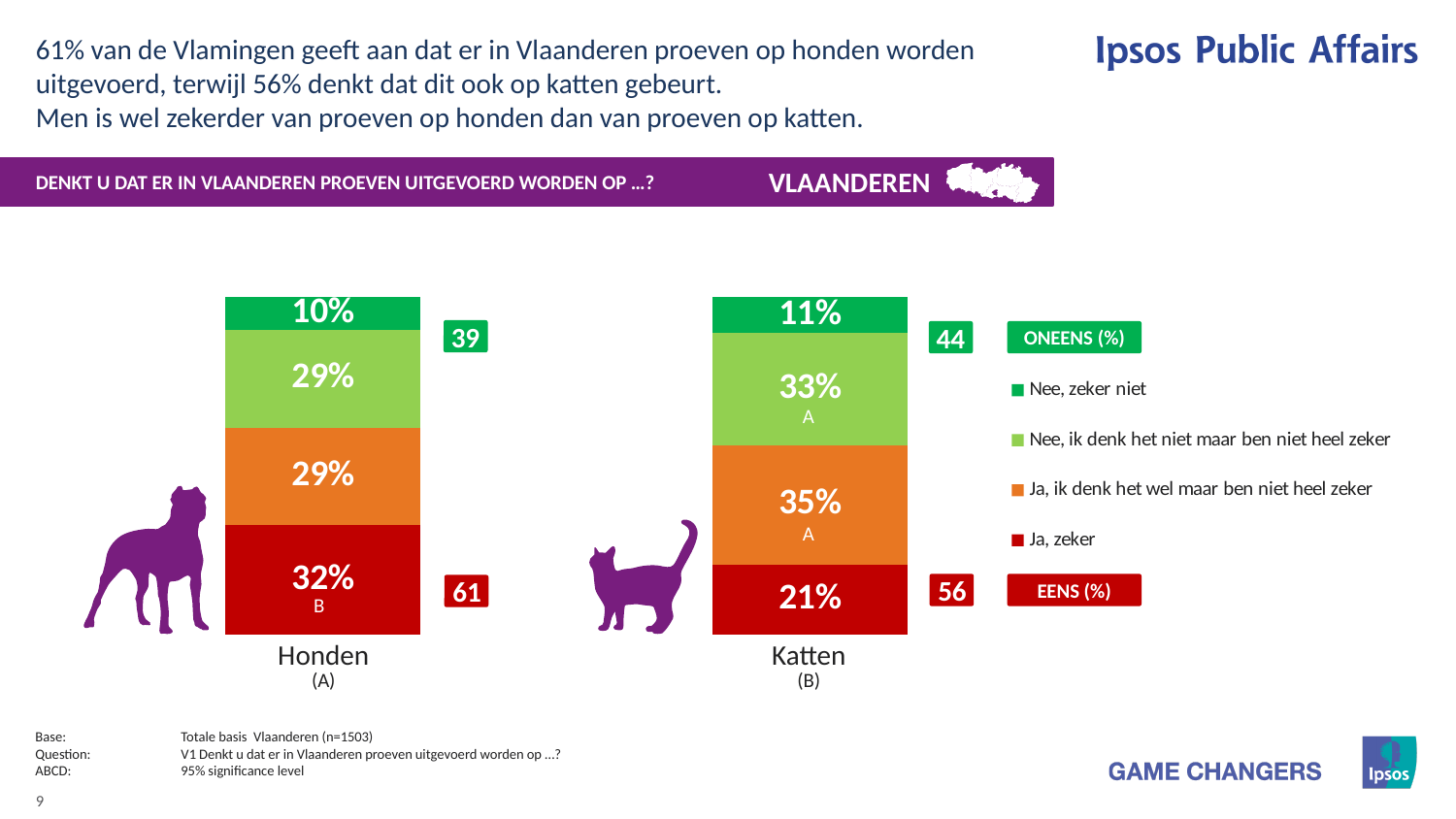
What is the combined share of the two "Ja" segments for Katten? 56% What is the value of the "Nee, zeker niet" segment for Katten? 11% What kind of chart is shown on the slide? Stacked bar chart How many series does the legend list? 4 What percentage of respondents answered "Ja, zeker" for Honden? 32% How many categories are shown on the x axis of the chart? 2 What is the EENS (%) total shown for Honden? 61 Which category has the larger "Ja, zeker" share, Honden or Katten? Honden What percentage of respondents answered "Ja, zeker" for Katten? 21% What is the difference between the "Ja, zeker" values for Honden and Katten? 11 percentage points What is the ONEENS (%) total shown for Katten? 44 What is the value of the "Ja, ik denk het wel maar ben niet heel zeker" segment for Honden? 29%